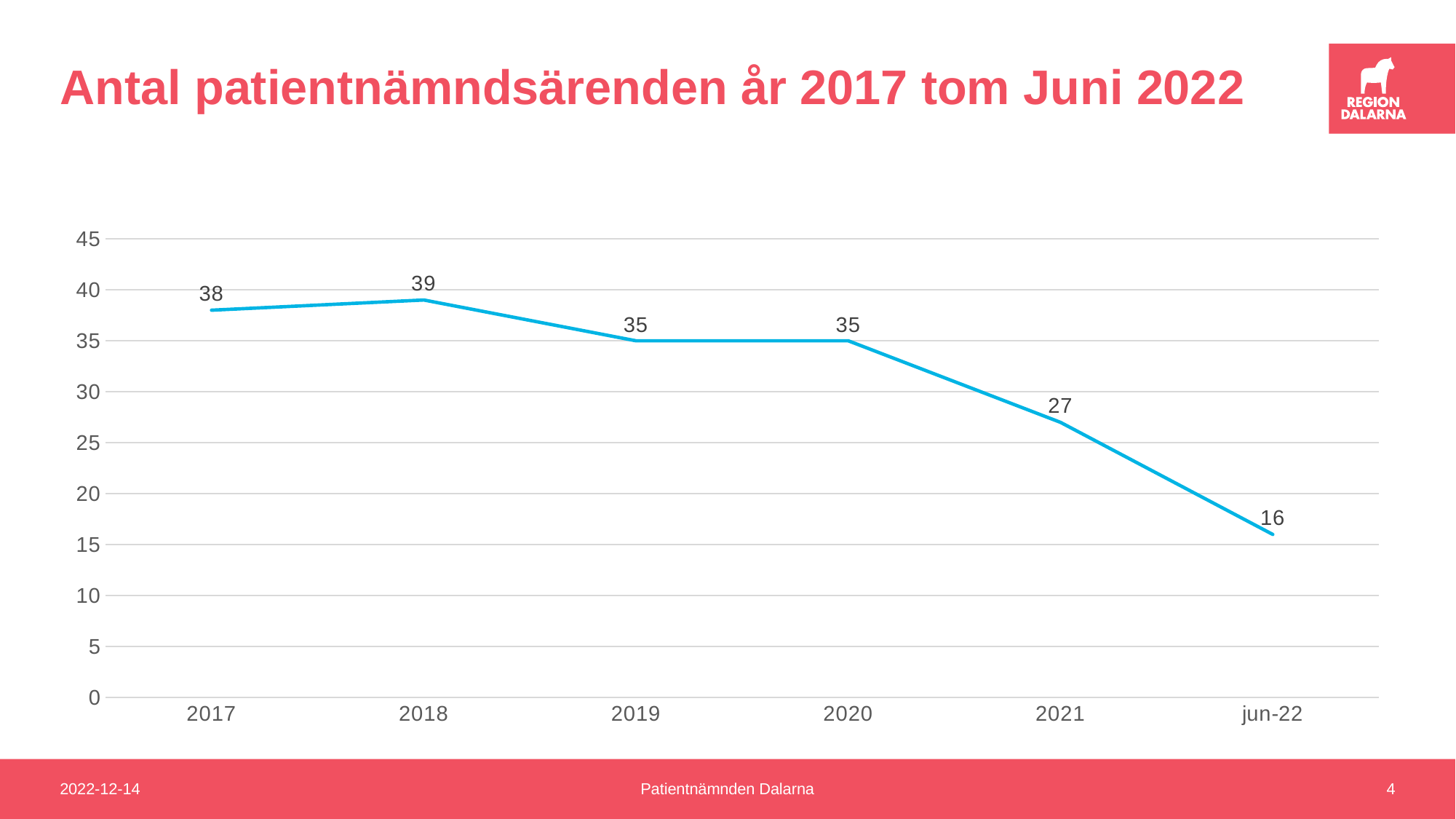
How many points are plotted on the x axis? 6 Which is larger, the value for 2017 or the value for 2018? 2018 What is the value for jun-22? 16 What is the difference between the values for 2018 and 2021? 12 Is the value for 2021 greater or less than 30? less What is the difference between the values for 2020 and jun-22? 19 What is the value for 2017? 38 Which point on the x axis has the lowest value? jun-22 What is the value for 2021? 27 What kind of chart is shown on the slide? line chart Do the values rise or fall from 2018 to jun-22? fall Which point on the x axis has the highest value? 2018